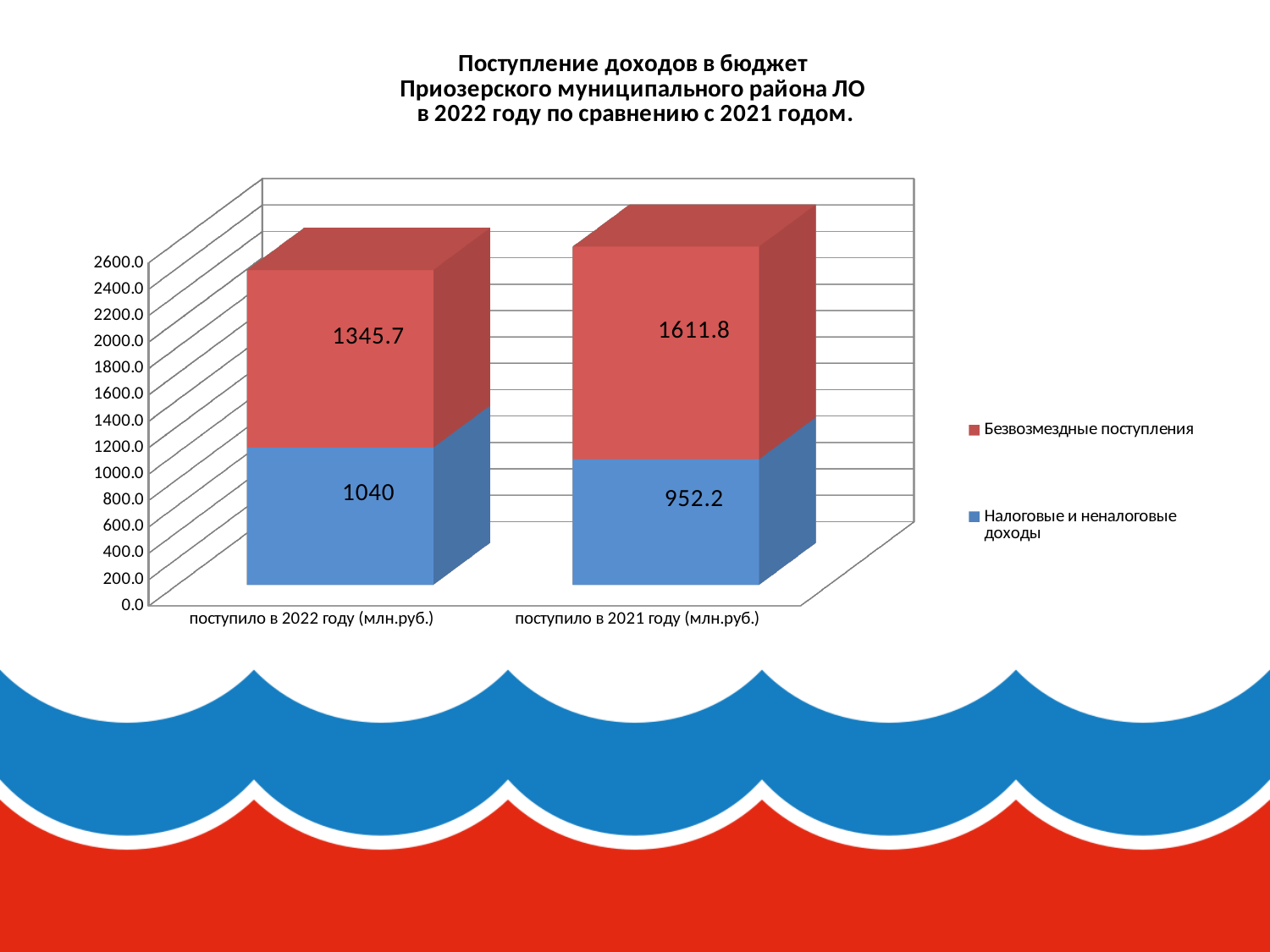
Which category has the higher value for Безвозмездные поступления? поступило в 2021 году (млн.руб.) What is the value of Налоговые и неналоговые доходы for поступило в 2021 году (млн.руб.)? 952.2 How many series does the legend list? 2 What is the total of the stacked bar for поступило в 2021 году (млн.руб.)? 2564 What is the difference between the Налоговые и неналоговые доходы values for 2022 and 2021? 87.8 What is the value of Безвозмездные поступления for поступило в 2021 году (млн.руб.)? 1611.8 What is the difference between the Безвозмездные поступления values for 2021 and 2022? 266.1 What is the value of Безвозмездные поступления for поступило в 2022 году (млн.руб.)? 1345.7 What kind of chart is shown on the slide? Stacked bar chart What is the total of the stacked bar for поступило в 2022 году (млн.руб.)? 2385.7 What is the value of Налоговые и неналоговые доходы for поступило в 2022 году (млн.руб.)? 1040 Which category has the lower value for Налоговые и неналоговые доходы? поступило в 2021 году (млн.руб.)